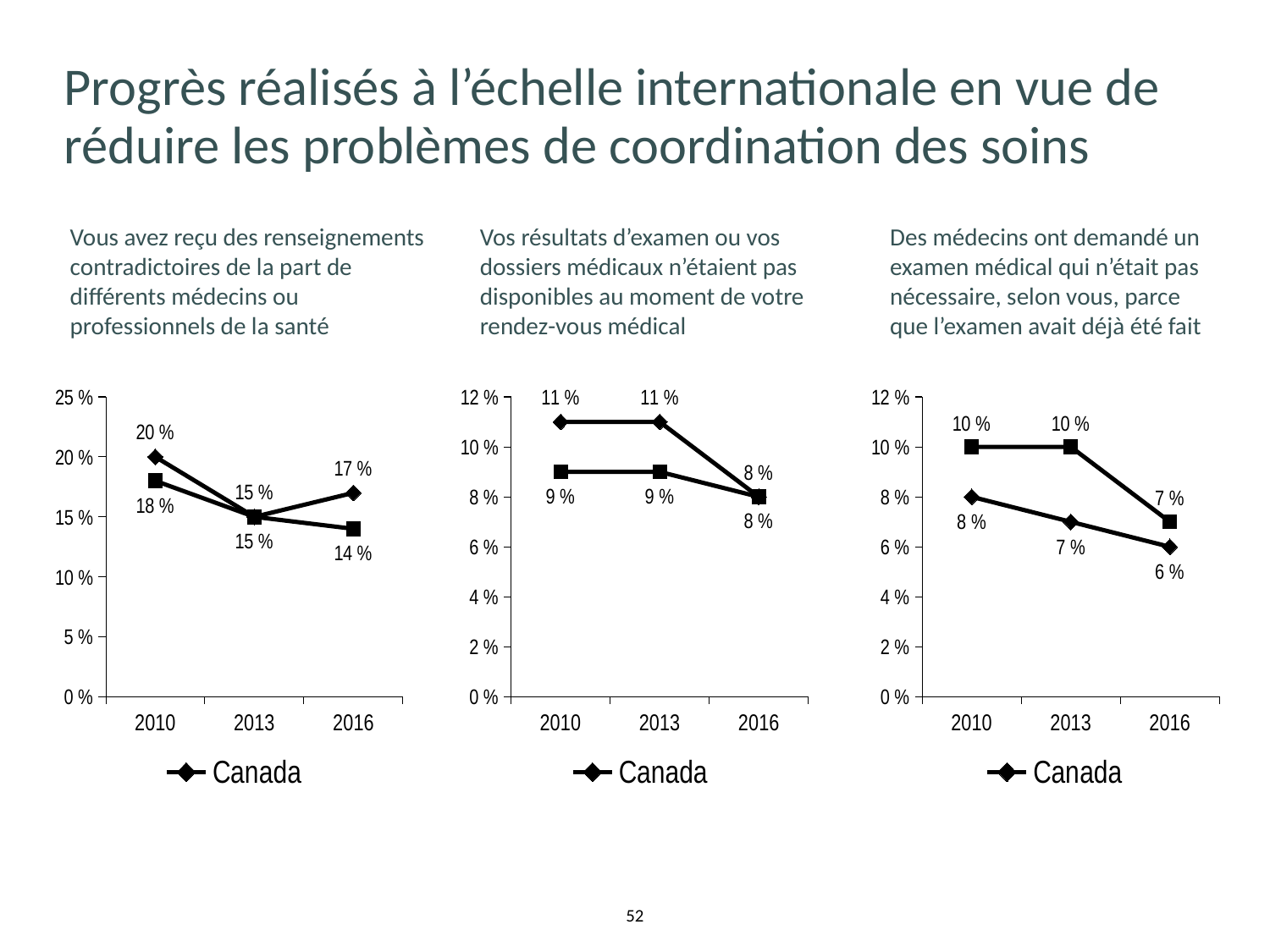
In the left chart, what is the value for Canada in 2010? 20 % In the left chart, in which year is the Canada value lowest? 2013 In the left chart, what is the difference between the Canada values for 2010 and 2013? 5 % In the left chart, what is the value for Canada in 2016? 17 % In the right chart, what is the value for Canada in 2010? 8 % In the middle chart, what is the value for Canada in 2013? 11 % In the middle chart, is the Canada value for 2010 greater or less than 10 %? greater In the right chart, does the Canada value rise or fall from 2010 to 2016? fall In the right chart, what is the difference between the Canada values for 2010 and 2016? 2 % What kind of chart is the middle chart? line chart How many years are shown on the x axis of the right chart? 3 In the middle chart, what is the value for Canada in 2016? 8 %